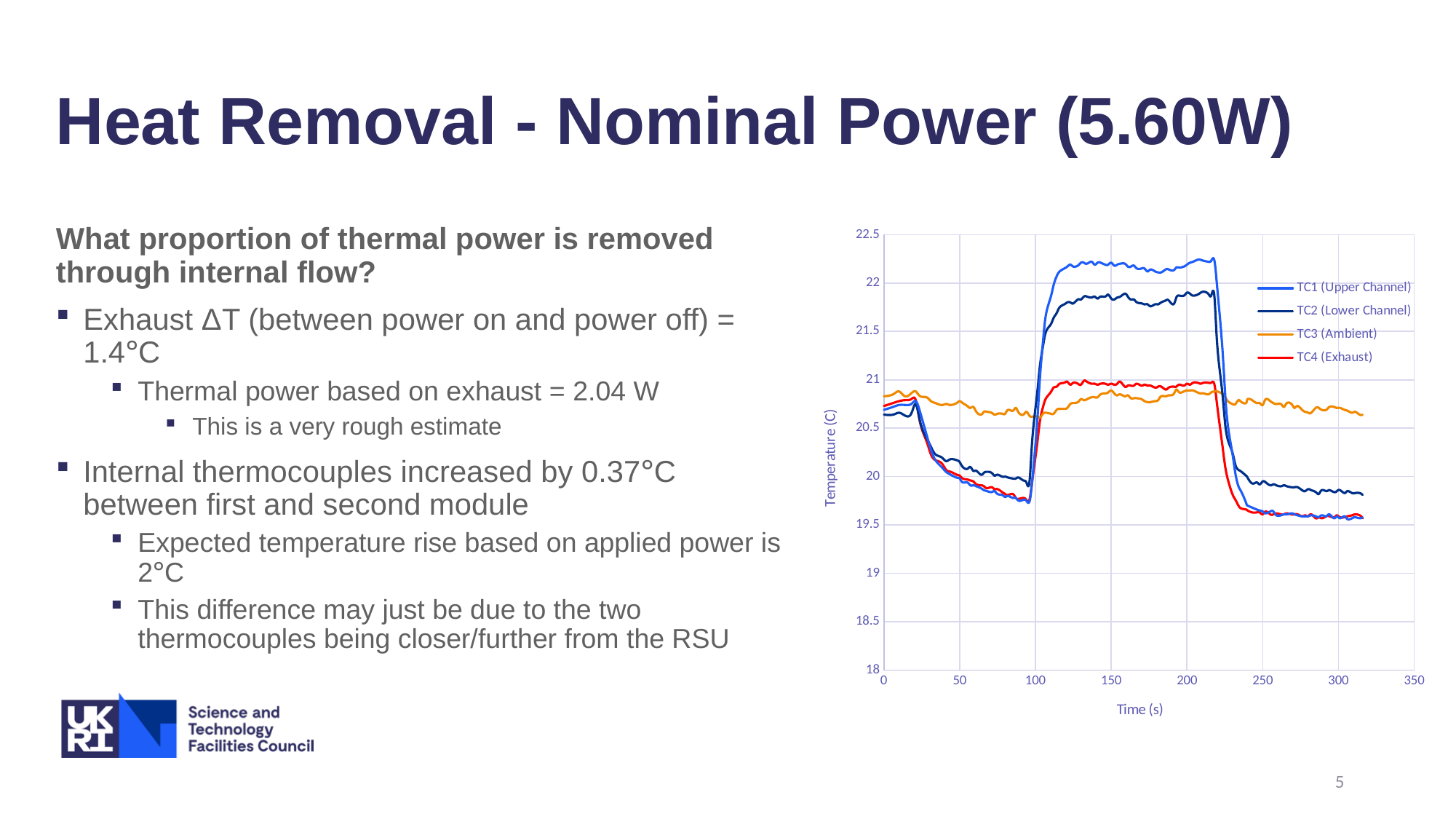
How many series does the chart legend list? 4 What is the label of the y axis of the chart? Temperature (C) Is the peak value of TC1 (Upper Channel) greater or less than 22? greater Does the TC1 (Upper Channel) series rise or fall between about 200 s and 250 s? fall Which series reaches the highest temperature on the chart, TC1 (Upper Channel) or TC2 (Lower Channel)? TC1 (Upper Channel) Does the TC2 (Lower Channel) series rise or fall between about 90 s and 120 s? rise Is the peak value of TC2 (Lower Channel) greater or less than 22? less Is the value of TC3 (Ambient) at around 300 s greater or less than 20.5? greater What is the label of the x axis of the chart? Time (s) What kind of chart is shown on the slide? line chart Between about 100 s and 200 s, which series is higher, TC3 (Ambient) or TC4 (Exhaust)? TC4 (Exhaust)